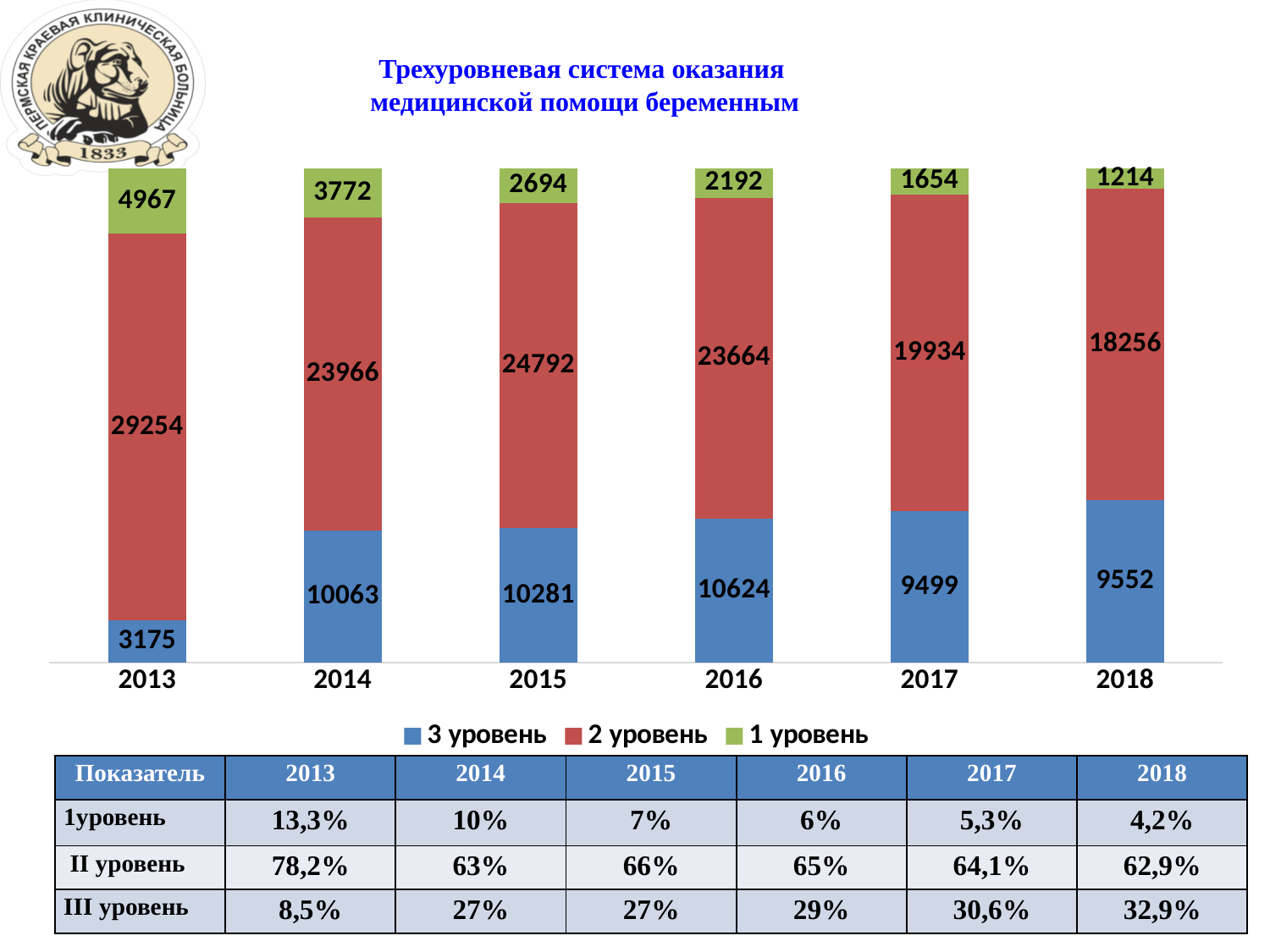
What is the value for 2 уровень in 2015? 24792 What is the total of the stacked bar for 2018? 29022 What is the difference between the 3 уровень values for 2016 and 2017? 1125 Do the values for 1 уровень rise or fall from 2013 to 2018? fall What is the value for 1 уровень in 2018? 1214 Which is larger: the 2 уровень value in 2014 or in 2016? 2014 How many series does the legend list? 3 What is the value for 3 уровень in 2013? 3175 How many years are shown on the x axis? 6 In which year is the value for 1 уровень highest? 2013 What kind of chart is shown on the slide? stacked bar chart In which year is the value for 2 уровень lowest? 2018